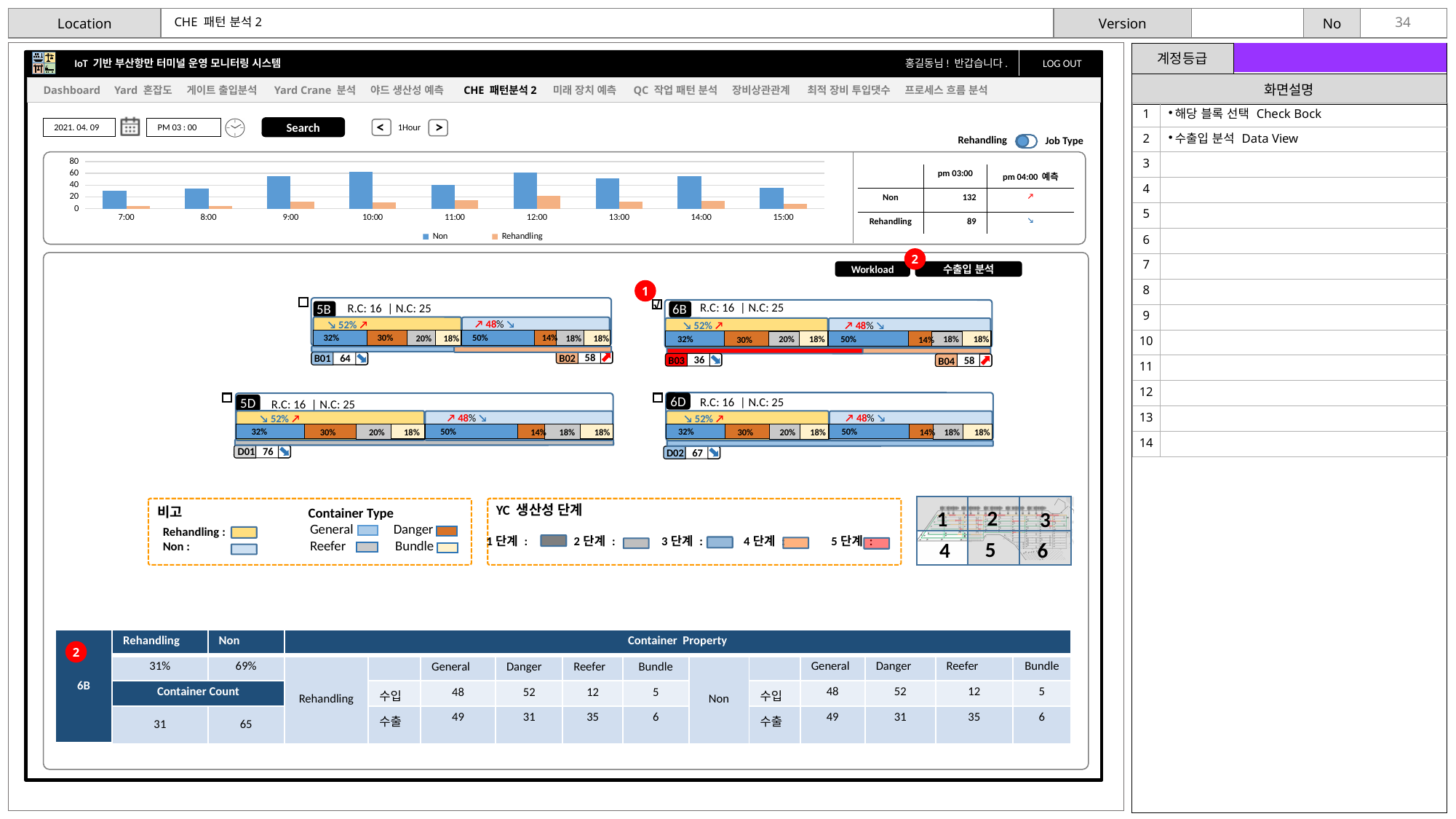
In the top hourly chart, is the Rehandling value at 9:00 greater or less than 20? less How many time categories are shown on the x axis of the top hourly chart? 9 How many series does the legend of the top hourly chart list? 2 In the top hourly chart, do the Non values rise or fall from 7:00 to 10:00? rise In the top hourly chart, is the Non value at 10:00 greater or less than 40? greater In the top hourly chart, which is larger for the Non series, the bar at 9:00 or the bar at 7:00? 9:00 What kind of chart is the hourly chart at the top of the slide? bar chart What is the highest value shown on the y axis of the top hourly chart? 80 In the top hourly chart, at which time is the Rehandling bar highest? 12:00 What are the two series named in the legend of the top hourly chart? Non and Rehandling In the top hourly chart, is the Non value at 7:00 greater or less than 40? less In the top hourly chart, which is larger at 12:00, the Non bar or the Rehandling bar? Non